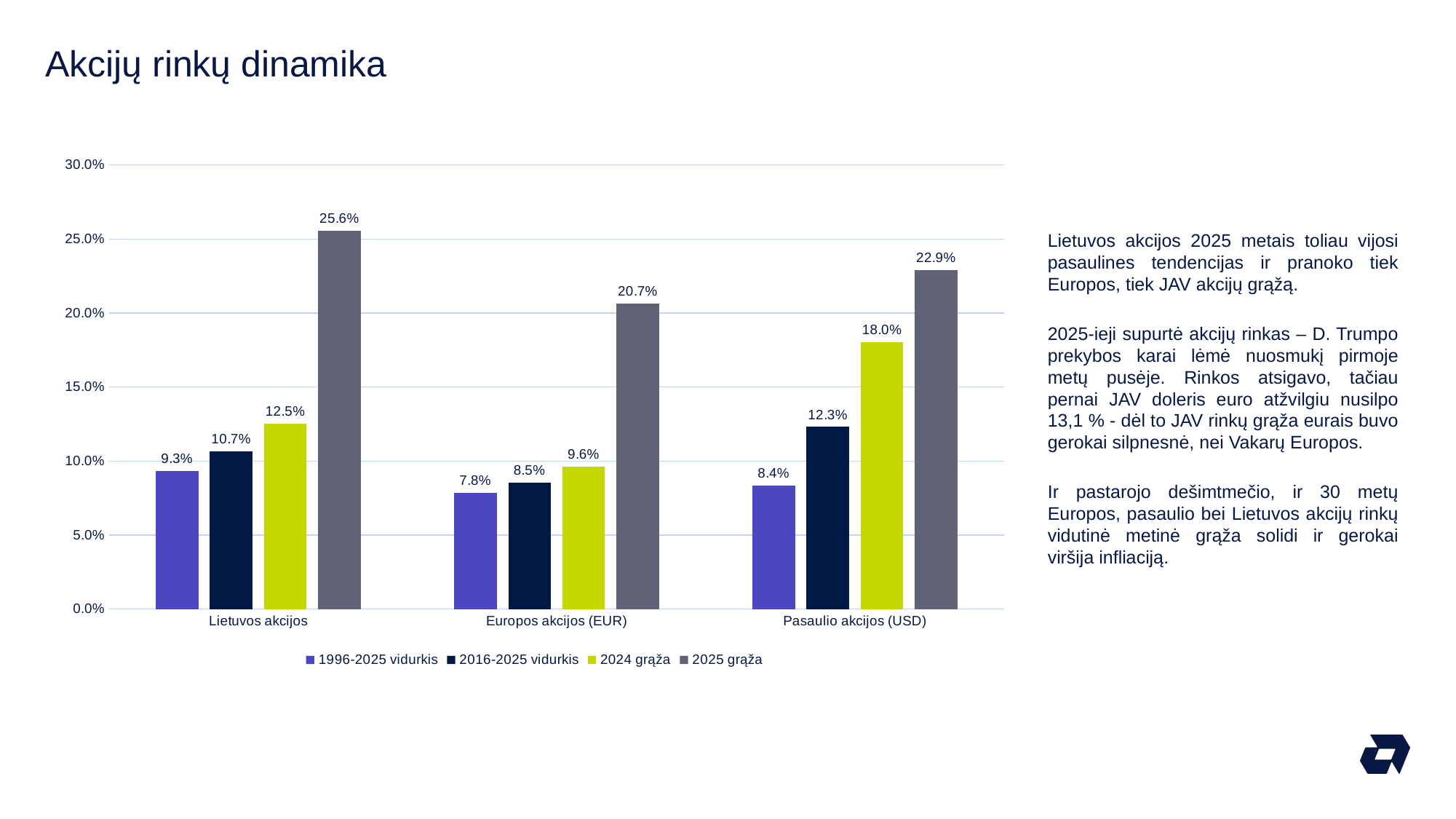
Which is larger: the 2024 grąža for Lietuvos akcijos or the 2024 grąža for Pasaulio akcijos (USD)? Pasaulio akcijos (USD) What is the 2024 grąža value for Pasaulio akcijos (USD)? 18.0% How many categories are shown on the x axis? 3 What is the difference between the 2025 grąža and 2024 grąža values for Europos akcijos (EUR)? 11.1% Which category has the lowest 2016-2025 vidurkis value? Europos akcijos (EUR) Is the 2025 grąža value for Pasaulio akcijos (USD) greater or less than 20.0%? greater Which category has the highest 2025 grąža value? Lietuvos akcijos How many series does the legend list? 4 What is the 1996-2025 vidurkis value for Europos akcijos (EUR)? 7.8% What is the 2025 grąža value for Lietuvos akcijos? 25.6% What kind of chart is shown on the slide? bar chart What is the title of the slide? Akcijų rinkų dinamika